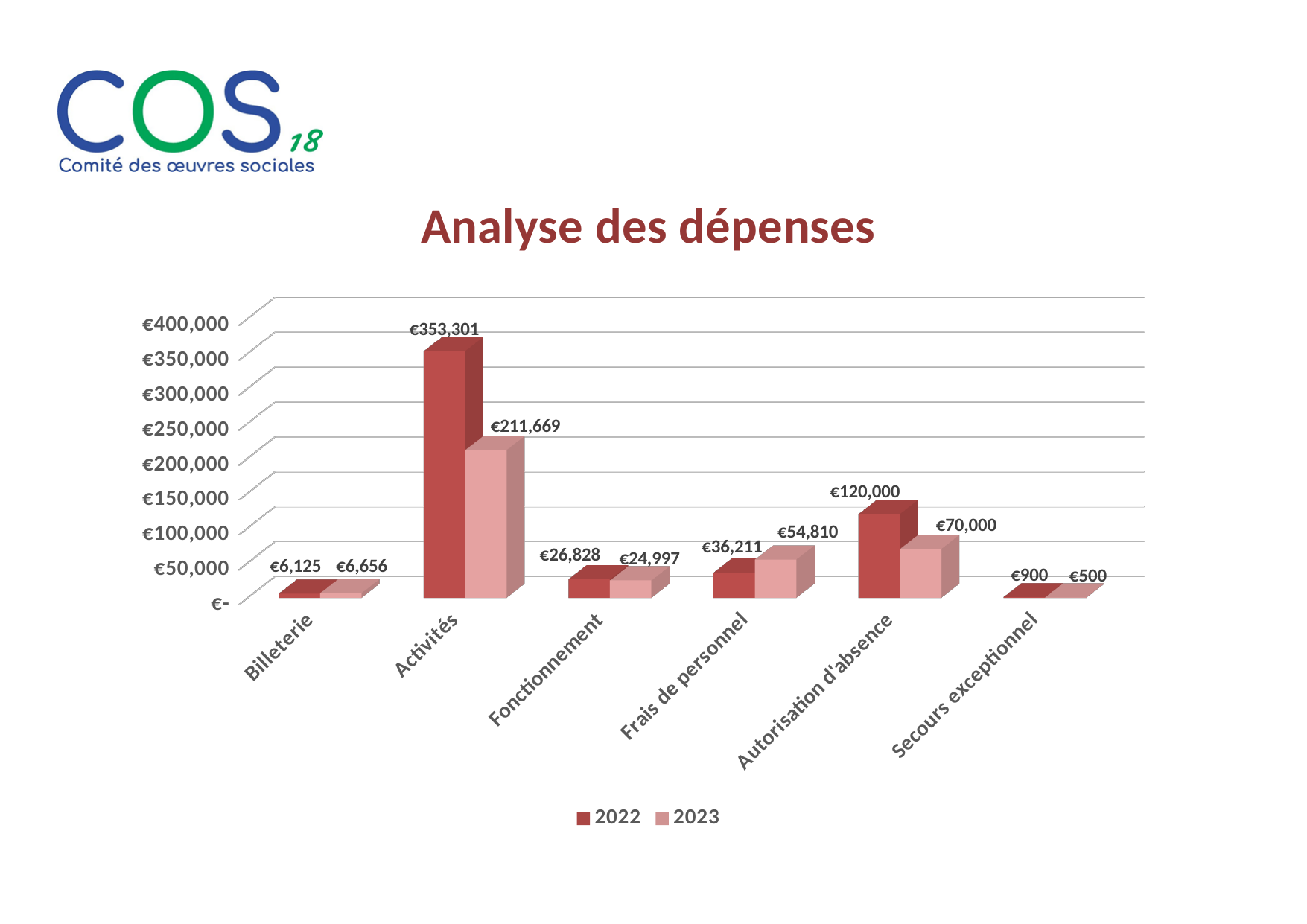
What kind of chart is shown on the slide? Bar chart What is the 2023 value for Secours exceptionnel? €500 Which category has the lowest 2023 value? Secours exceptionnel How many categories are shown on the x axis? 6 For Frais de personnel, which year has the larger value, 2022 or 2023? 2023 What is the difference between the 2022 and 2023 values for Autorisation d'absence? €50,000 What is the difference between the 2022 and 2023 values for Activités? €141,632 What is the 2022 value for Autorisation d'absence? €120,000 What is the 2023 value for Frais de personnel? €54,810 How many series does the legend list? 2 Which category has the highest 2022 value? Activités What is the 2022 value for Activités? €353,301